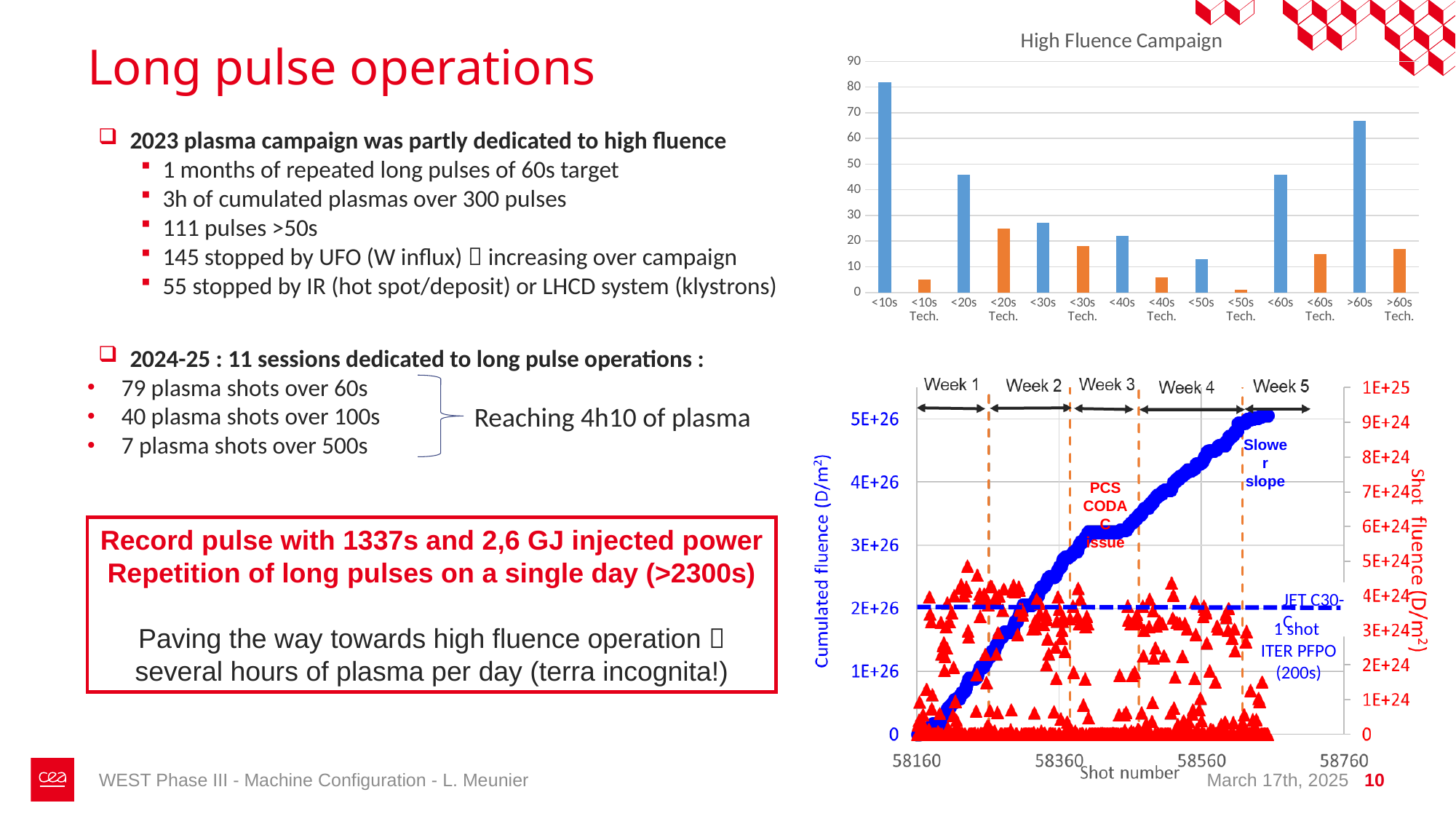
In the High Fluence Campaign chart, how many categories are shown on the x axis? 14 In the High Fluence Campaign chart, which category has the highest bar? <10s In the High Fluence Campaign chart, which is larger, the value for <10s or the value for >60s? <10s In the High Fluence Campaign chart, what kind of chart is shown? bar chart In the High Fluence Campaign chart, is the value for <50s Tech. greater or less than 10? less What is the title of the bar chart at the top right of the slide? High Fluence Campaign In the High Fluence Campaign chart, which category has the lowest bar? <50s Tech. In the bottom-right chart, does the cumulated fluence rise or fall as the shot number increases? rise In the High Fluence Campaign chart, is the value for >60s greater or less than 60? greater In the High Fluence Campaign chart, which is larger, the value for <30s Tech. or the value for <40s Tech.? <30s Tech. In the High Fluence Campaign chart, is the value for <10s greater or less than 70? greater In the bottom-right chart, what is the label of the x axis? Shot number